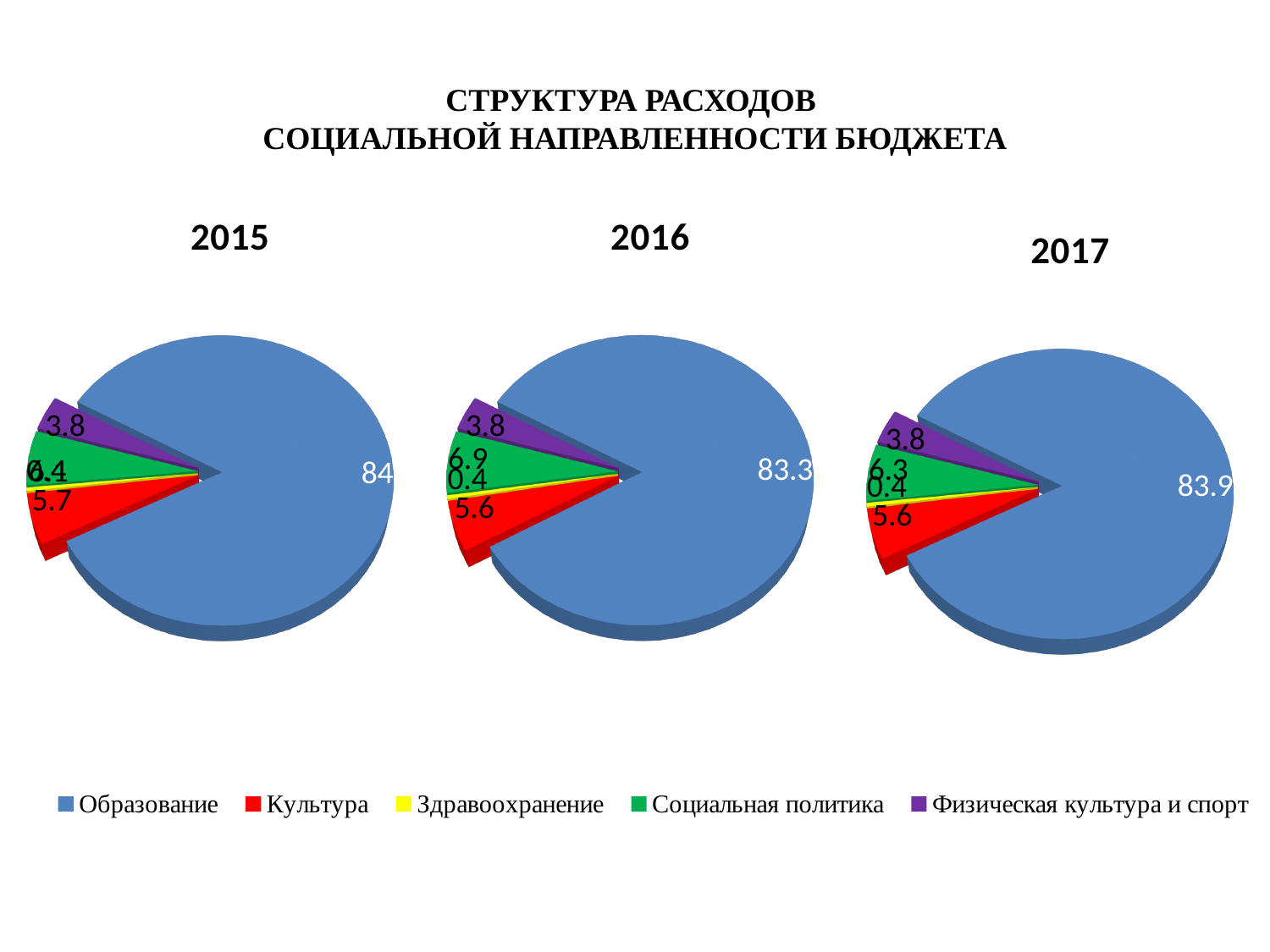
In the 2015 pie chart, what is the value for Культура? 5.7 In the 2017 pie chart, what is the value for Социальная политика? 6.3 In the 2017 pie chart, what is the value for Образование? 83.9 In the 2015 pie chart, what is the value for Образование? 84 In the 2016 pie chart, which is larger: Культура or Социальная политика? Социальная политика In the 2016 pie chart, which category has the largest slice? Образование In the 2016 pie chart, what is the value for Образование? 83.3 In the 2016 pie chart, what is the value for Социальная политика? 6.9 In the 2017 pie chart, what is the value for Физическая культура и спорт? 3.8 How many categories does the legend list? 5 What is the difference between the Образование values in the 2017 and 2016 pie charts? 0.6 In the 2017 pie chart, which category has the smallest slice? Здравоохранение